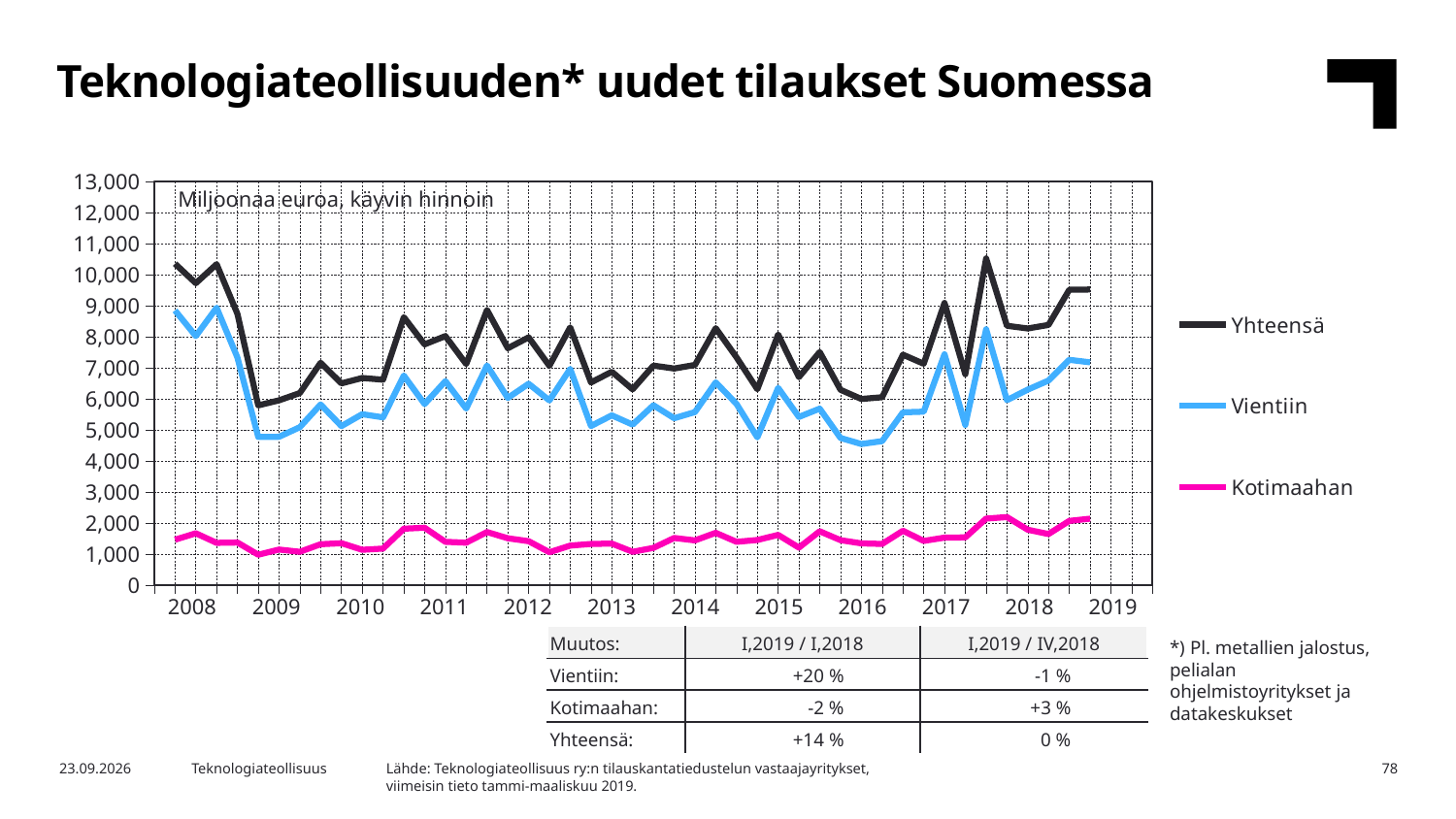
Does the Yhteensä line rise or fall from the start of 2008 to the start of 2009? fall What kind of chart is shown on the slide? Line chart Is the Kotimaahan value at the start of 2008 greater or less than 3,000? less At the start of 2019, which is larger, the Vientiin value or the Kotimaahan value? Vientiin Is the Vientiin value at the start of 2009 greater or less than 6,000? less Which series is plotted with the lowest values across the whole chart? Kotimaahan Which series is plotted with the highest values across the whole chart? Yhteensä What unit label is shown inside the chart area? Miljoonaa euroa, käyvin hinnoin How many years are labelled on the x axis? 12 How many series does the chart legend list? 3 Is the Yhteensä value at the start of 2008 greater or less than 9,000? greater